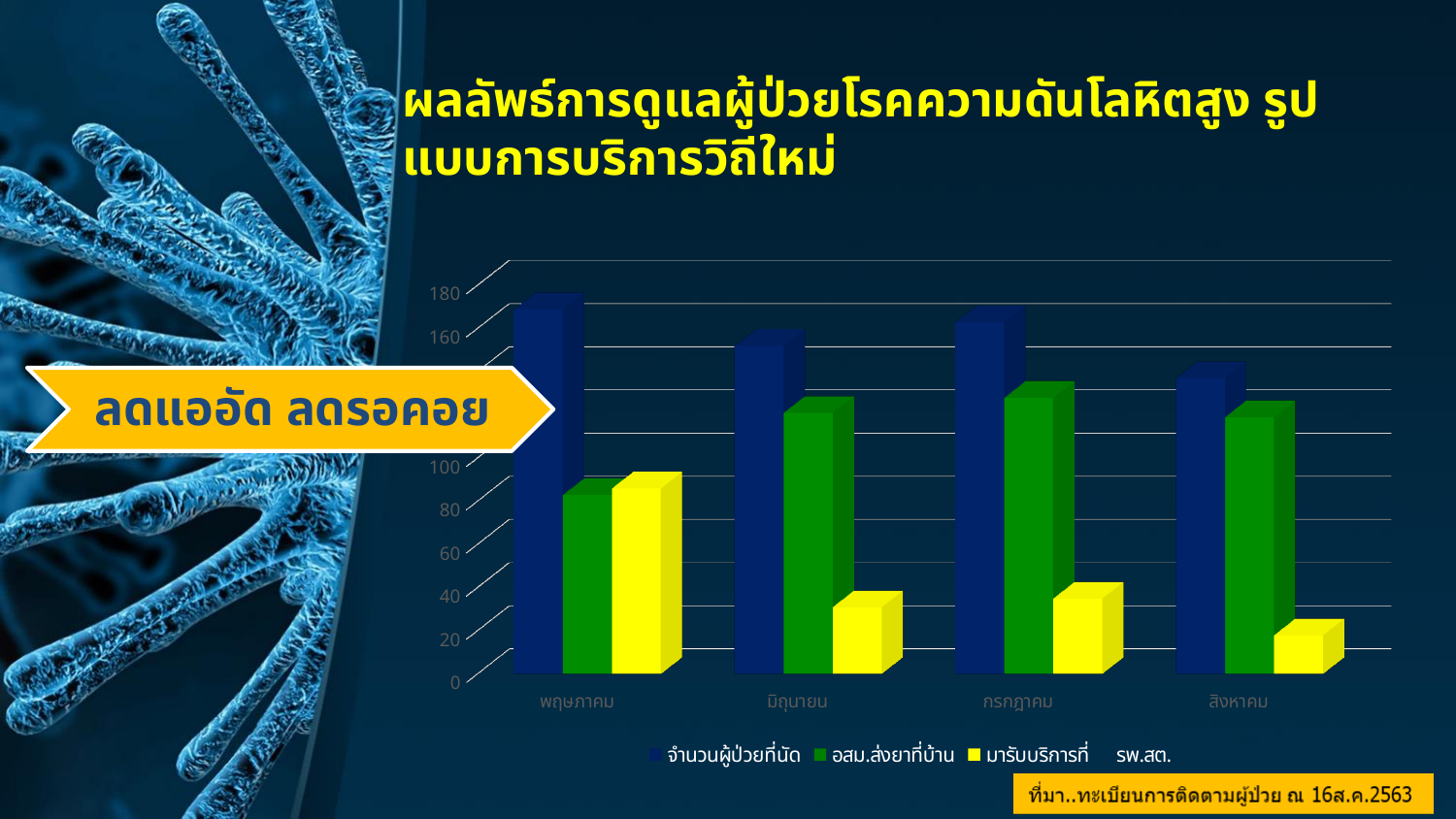
Which month has the lowest value for มารับบริการที่ รพ.สต.? สิงหาคม Which month has the lowest value for จำนวนผู้ป่วยที่นัด? สิงหาคม In พฤษภาคม, which is larger: จำนวนผู้ป่วยที่นัด or มารับบริการที่ รพ.สต.? จำนวนผู้ป่วยที่นัด How many series does the chart legend list? 3 What colour represents the series อสม.ส่งยาที่บ้าน in the chart? green Which month has the highest value for มารับบริการที่ รพ.สต.? พฤษภาคม How many months (categories) are shown on the x axis of the chart? 4 Is the value for อสม.ส่งยาที่บ้าน in กรกฎาคม greater or less than 100? greater Is the value for จำนวนผู้ป่วยที่นัด in พฤษภาคม greater or less than 160? greater What kind of chart is shown on the slide? bar chart Is the value for มารับบริการที่ รพ.สต. in มิถุนายน greater or less than 60? less In สิงหาคม, which is larger: อสม.ส่งยาที่บ้าน or มารับบริการที่ รพ.สต.? อสม.ส่งยาที่บ้าน